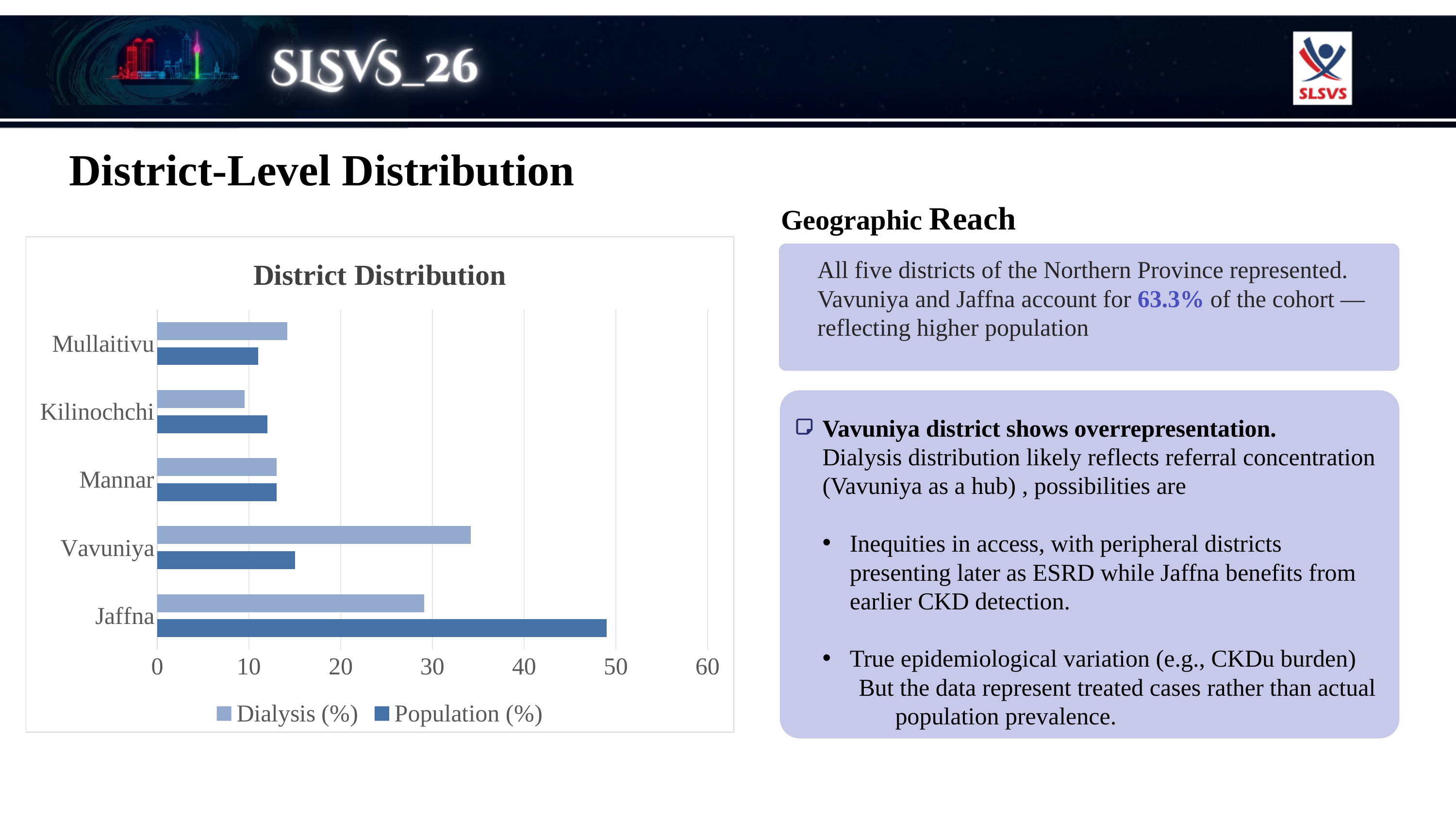
What kind of chart is shown on the slide? bar chart Which district has the lowest Dialysis (%) value? Kilinochchi Is the Population (%) value for Jaffna greater or less than 40? greater Which district has the highest Population (%) value? Jaffna Is the Dialysis (%) value for Kilinochchi greater or less than 10? less How many series does the chart legend list? 2 Is the Dialysis (%) value for Vavuniya greater or less than 30? greater How many districts are shown on the chart? 5 What is the title of the chart? District Distribution For Jaffna, which is larger: Dialysis (%) or Population (%)? Population (%) For Vavuniya, which is larger: Dialysis (%) or Population (%)? Dialysis (%) Which district has the highest Dialysis (%) value? Vavuniya